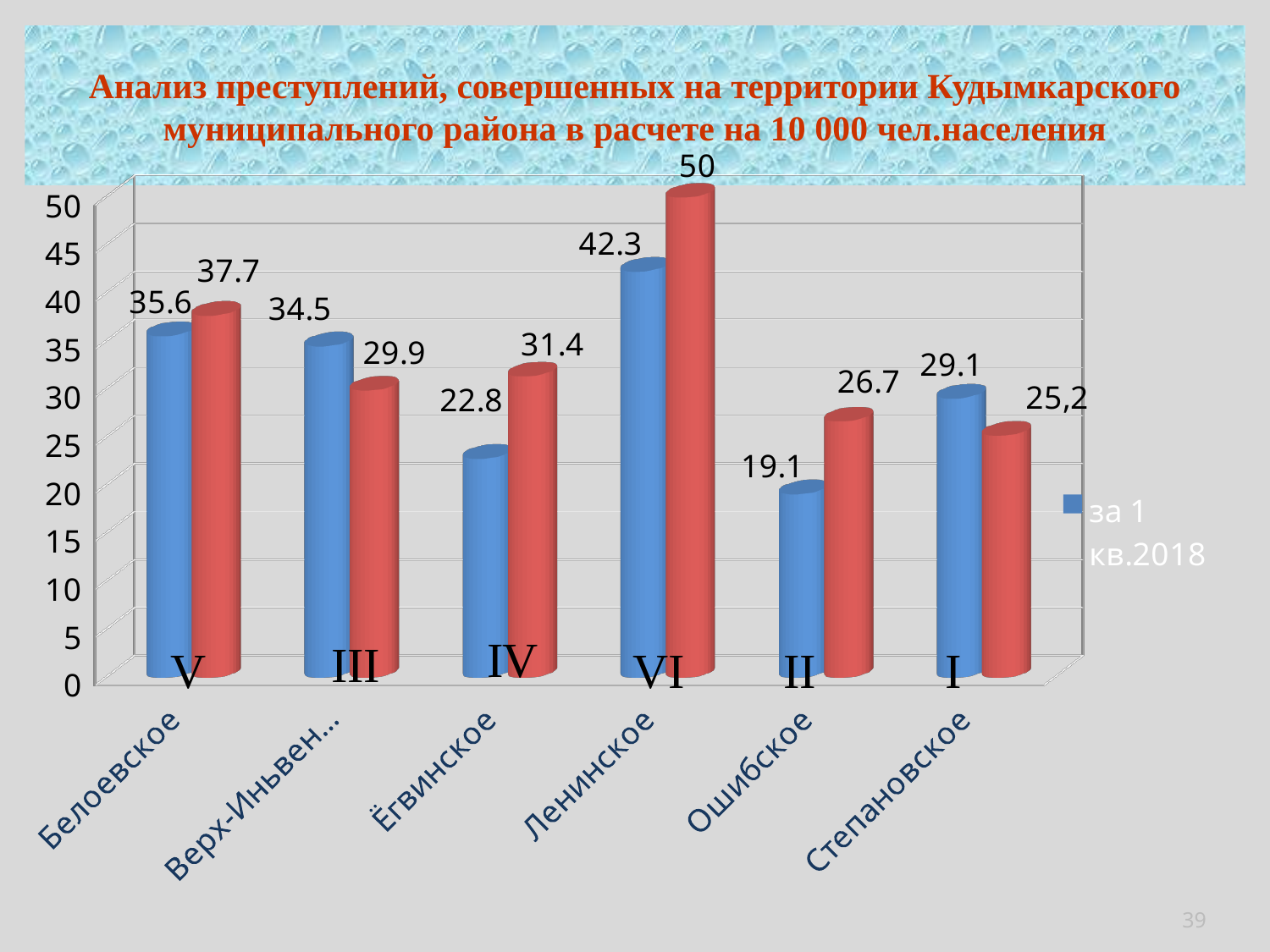
What is the value of the red bar for Степановское? 25,2 How many categories are shown on the x axis? 6 What is the value of the blue bar for Ошибское? 19.1 For the second category from the left (Верх-Иньвен...), which bar is larger, the blue or the red? blue What is the value of the red bar for Ёгвинское? 31.4 What is the difference between the red and blue bars for Белоевское? 2.1 What is the value of the blue bar for Ленинское? 42.3 What is the difference between the red and blue bars for Ленинское? 7.7 Which category has the lowest blue bar? Ошибское Is the blue bar for Ёгвинское greater or less than 25? less What kind of chart is shown on the slide? bar chart Which category has the highest red bar? Ленинское